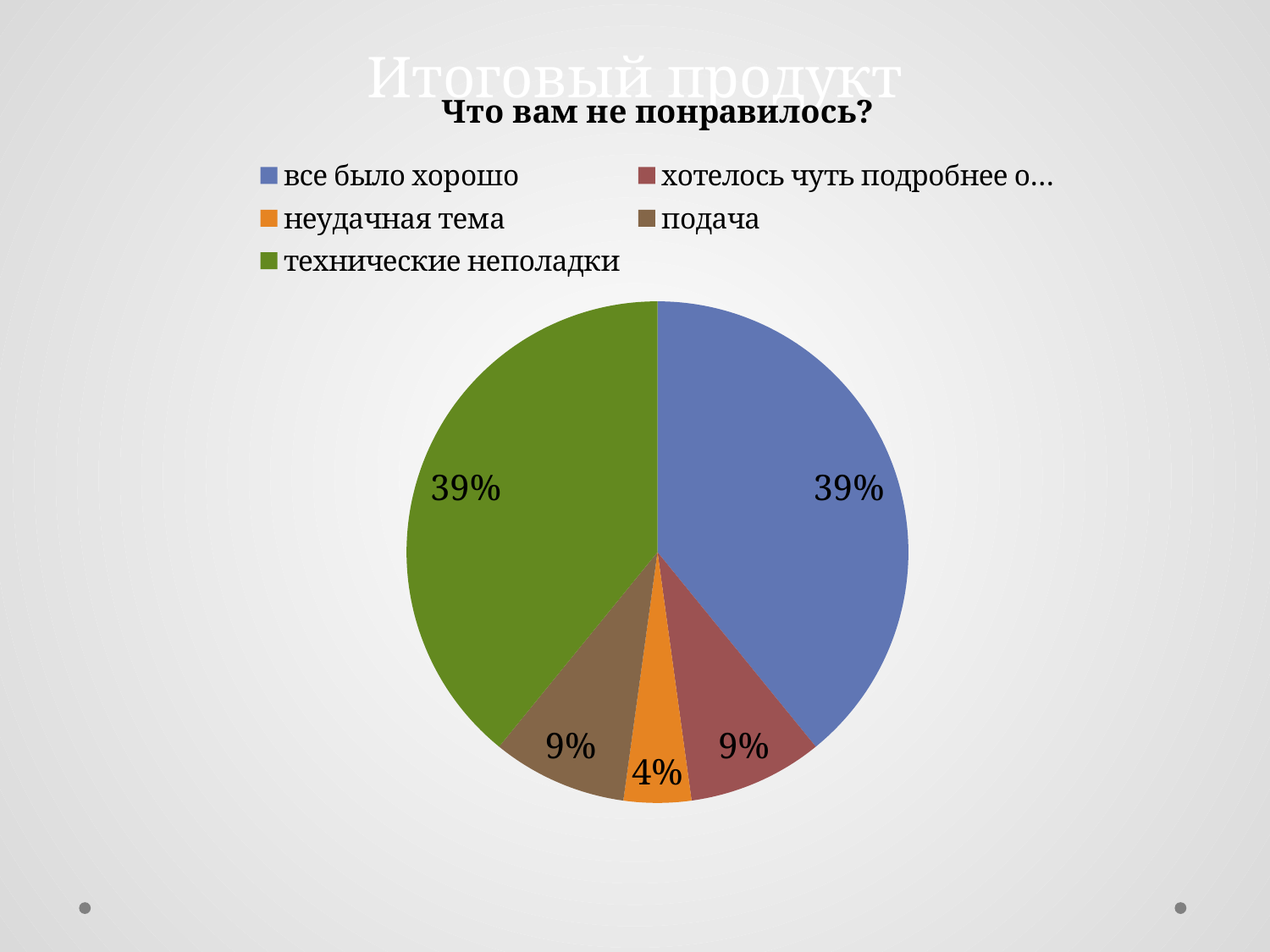
Which category has the smallest slice of the pie? неудачная тема What share of the pie does "технические неполадки" take? 39% What is the difference between the shares of "все было хорошо" and "подача"? 30% What is the combined share of "подача" and "неудачная тема"? 13% What share of the pie does "неудачная тема" take? 4% Which is larger, the share for "подача" or the share for "неудачная тема"? подача What share of the pie does "подача" take? 9% What colour is the slice for "технические неполадки"? green What is the title of the chart? Что вам не понравилось? How many categories does the pie chart show? 5 What kind of chart is shown on the slide? pie chart